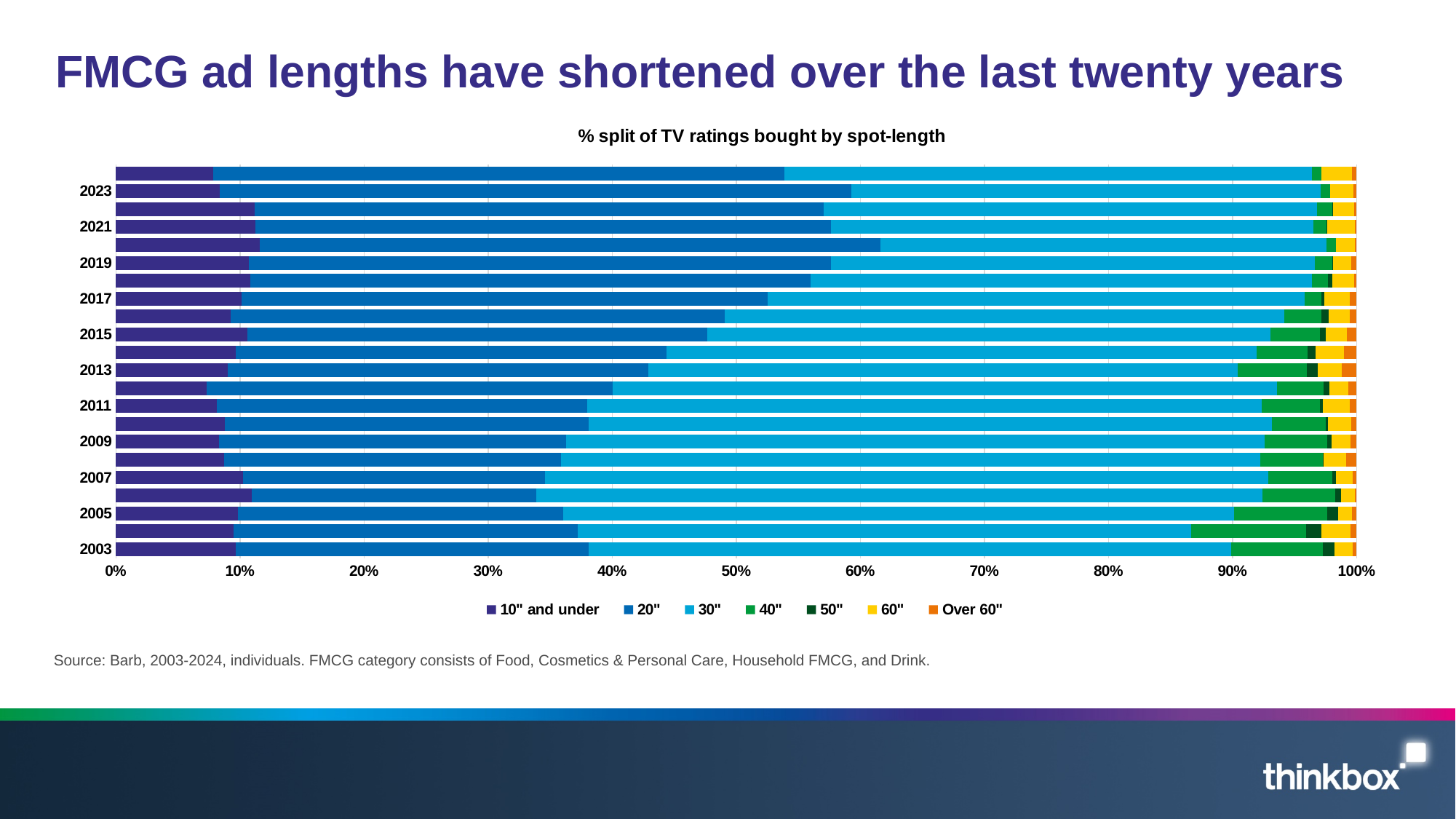
Is the 40" share larger in 2003 or in 2023? 2003 Does the share of 40" spots generally rise or fall from 2003 to the most recent year? fall Which series is listed first in the legend? 10" and under How many year labels are shown on the vertical axis? 11 Is the combined share of 10" and under and 20" spots for 2003 greater or less than 40%? less What is the chart's subtitle? % split of TV ratings bought by spot-length Does the share of 20" spots generally rise or fall from 2003 to the most recent year? rise Is the 20" share larger in 2023 or in 2003? 2023 Is the 10" and under share for 2023 greater or less than 10%? less Is the combined share of 10" and under and 20" spots for 2023 greater or less than 50%? greater What kind of chart is shown on the slide? Stacked bar chart How many series does the legend list? 7